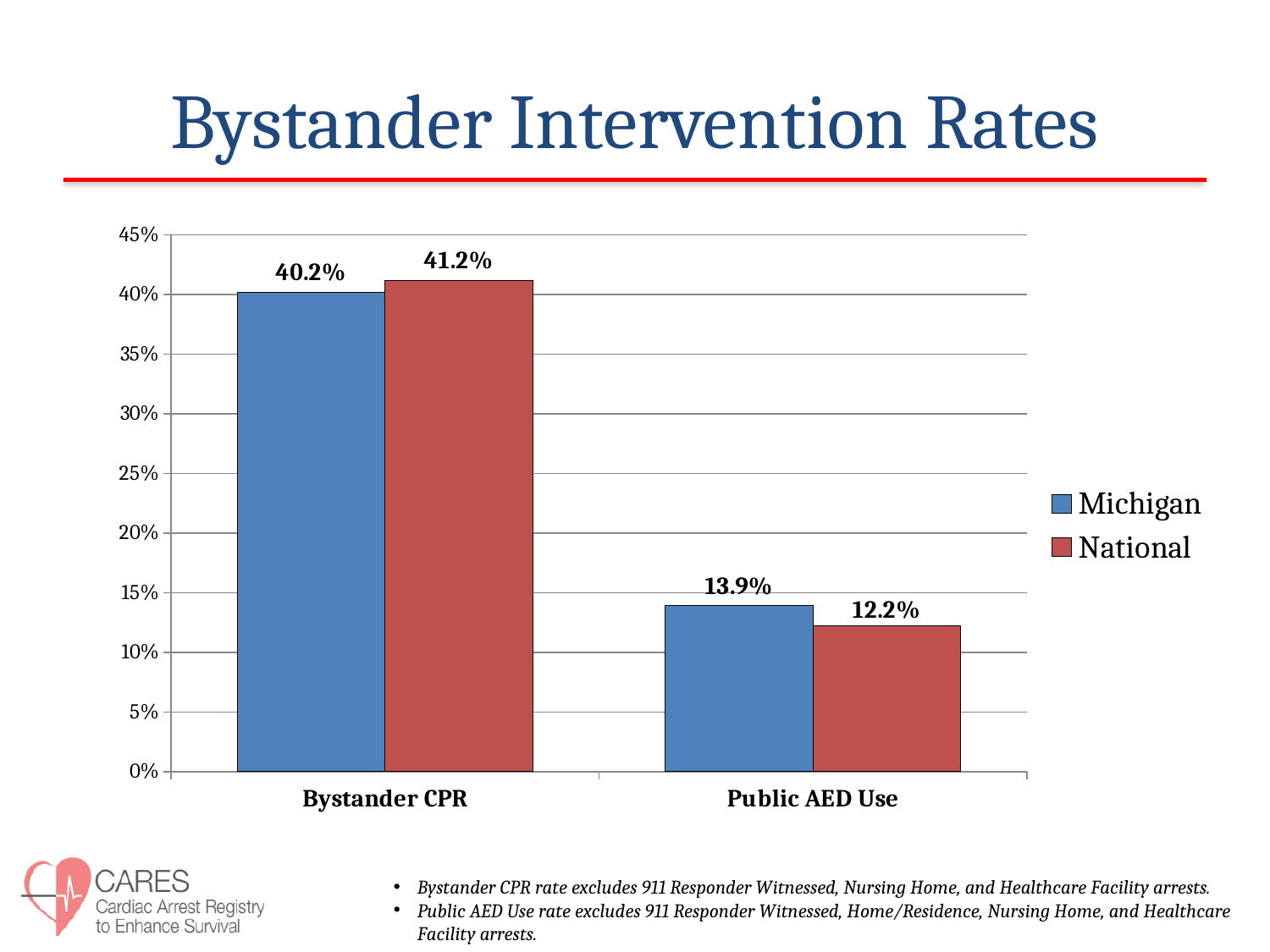
How many categories are shown on the x axis? 2 How many series does the legend list? 2 For Public AED Use, which is larger: Michigan or National? Michigan What is the difference between the Michigan and National values for Public AED Use? 1.7% Which category has the lowest National value? Public AED Use What is the National value for Public AED Use? 12.2% What is the Michigan value for Public AED Use? 13.9% What is the difference between the National and Michigan values for Bystander CPR? 1.0% What is the Michigan value for Bystander CPR? 40.2% What is the National value for Bystander CPR? 41.2% What kind of chart is shown on the slide? Bar chart Which category has the highest Michigan value? Bystander CPR